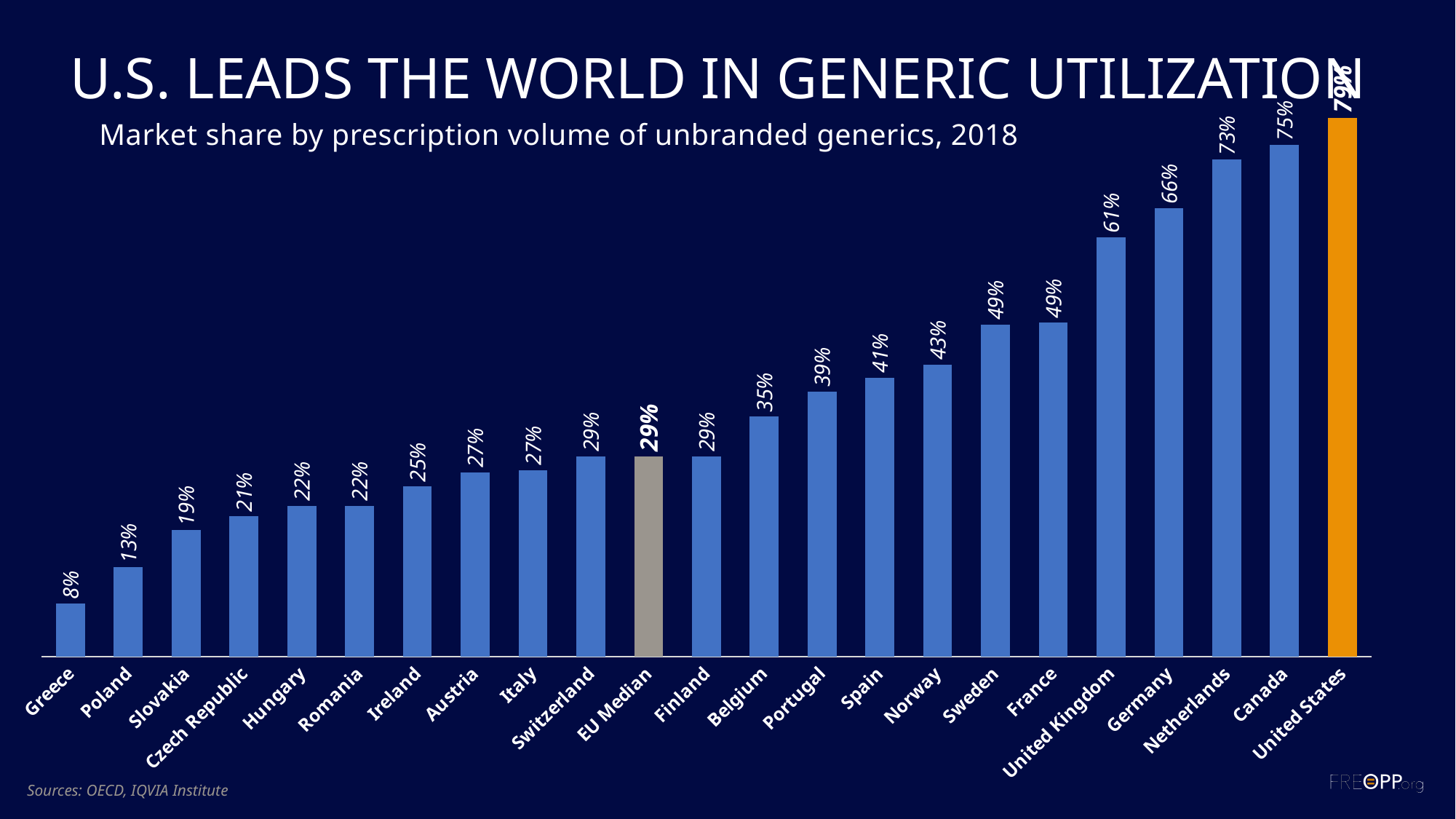
How many bars are shown in the chart? 23 Do the values generally rise or fall from left to right along the x axis? Rise What is the value shown for Greece? 8% What type of chart is shown on the slide? Bar chart Which country has the highest market share of unbranded generics? United States What is the difference between the values for the Netherlands and the United Kingdom? 12% Which bar is coloured orange instead of blue? United States What is the market share of unbranded generics for Germany? 66% Which country has the lowest market share of unbranded generics? Greece What is the market share of unbranded generics for Canada? 75% Which has a larger value, Belgium or Spain? Spain What is the value shown for the EU Median? 29%